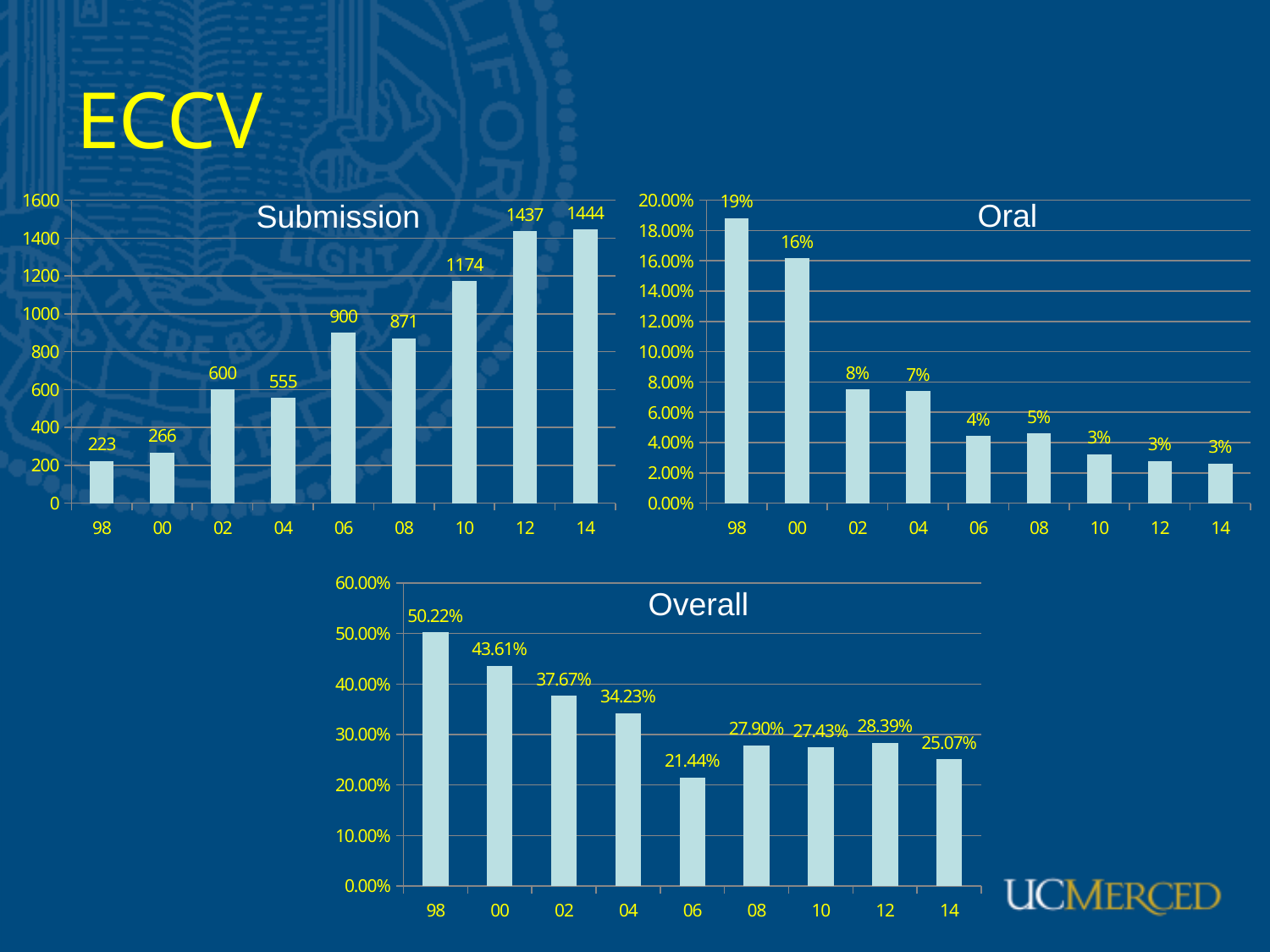
In the Overall chart, what is the difference between the values for 98 and 00? 6.61% In the Overall chart, which year has the lowest value? 06 In the Submission chart, which is larger, the value for 06 or the value for 08? 06 In the Submission chart, which year has the highest value? 14 In the Oral chart, is the value for 02 greater or less than 10.00%? less In the Submission chart, what is the difference between the values for 14 and 98? 1221 In the Submission chart, what is the value for 10? 1174 In the Overall chart, what is the value for 06? 21.44% How many years are shown on the x axis of the Overall chart? 9 What kind of chart is the Submission chart? bar chart In the Oral chart, which year has the highest value? 98 In the Oral chart, what is the value for 00? 16%